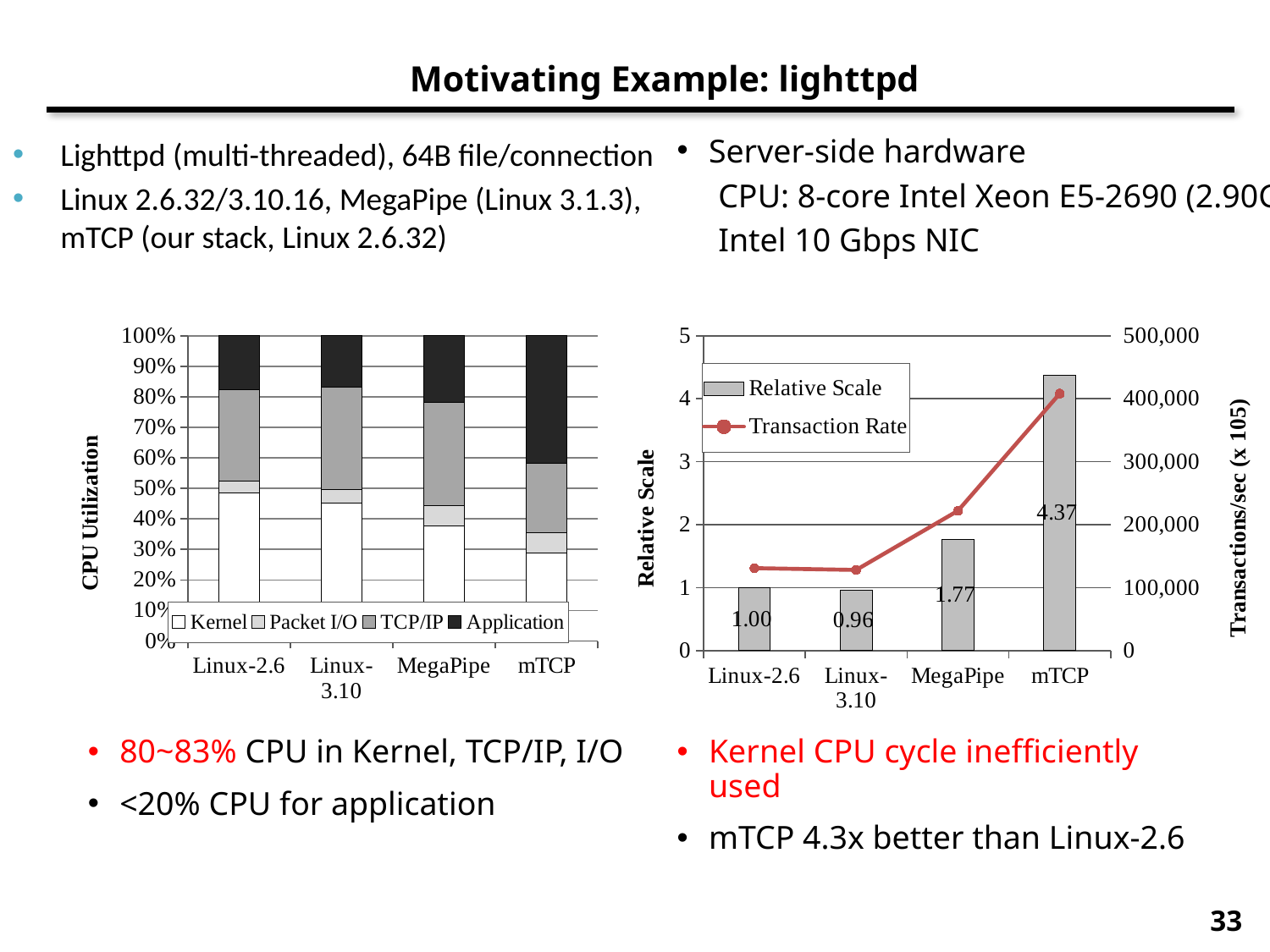
What kind of chart is the left CPU Utilization chart? stacked bar chart In the right chart, does the Transaction Rate line rise or fall from Linux-3.10 to mTCP? rise In the left CPU Utilization chart, how many series does the legend list? 4 In the right chart, what is the difference between the Relative Scale of MegaPipe and Linux-3.10? 0.81 In the left CPU Utilization chart, is the Kernel share for mTCP greater or less than 40%? less In the right chart, what is the Relative Scale value for MegaPipe? 1.77 In the right chart, which category has the lowest Relative Scale? Linux-3.10 In the right chart, how many series does the legend list? 2 In the right chart, what is the Relative Scale value for mTCP? 4.37 In the right chart, which category has the highest Relative Scale? mTCP In the right chart, what is the Relative Scale value for Linux-3.10? 0.96 In the right chart, what is the difference between the Relative Scale of mTCP and Linux-2.6? 3.37